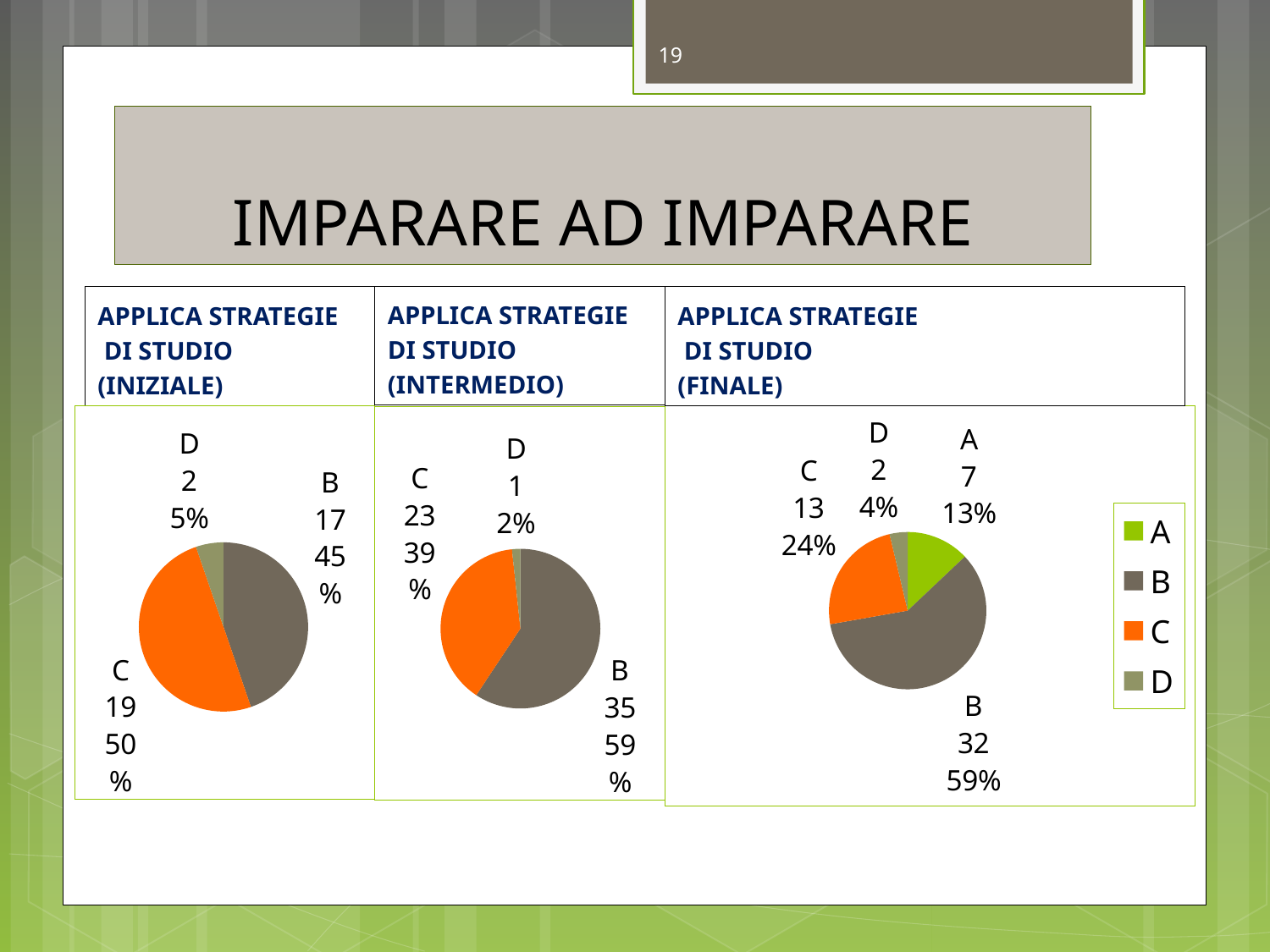
In the APPLICA STRATEGIE DI STUDIO (INIZIALE) chart, what share of the pie does category B have? 45% How many entries does the legend next to the APPLICA STRATEGIE DI STUDIO (FINALE) chart list? 4 In the APPLICA STRATEGIE DI STUDIO (INIZIALE) chart, what is the value for category C? 19 What type of chart is used for APPLICA STRATEGIE DI STUDIO (FINALE)? Pie chart In the APPLICA STRATEGIE DI STUDIO (INTERMEDIO) chart, what is the value for category B? 35 In the APPLICA STRATEGIE DI STUDIO (INTERMEDIO) chart, what share of the pie does category C have? 39% In the APPLICA STRATEGIE DI STUDIO (FINALE) chart, what is the value for category A? 7 In the APPLICA STRATEGIE DI STUDIO (INIZIALE) chart, which category has the smallest slice? D In the APPLICA STRATEGIE DI STUDIO (FINALE) chart, what share of the pie does category C have? 24% In the APPLICA STRATEGIE DI STUDIO (INTERMEDIO) chart, what is the difference between the values for B and C? 12 In the APPLICA STRATEGIE DI STUDIO (FINALE) chart, how many categories are shown in the pie? 4 In the APPLICA STRATEGIE DI STUDIO (INTERMEDIO) chart, which category has the largest slice? B